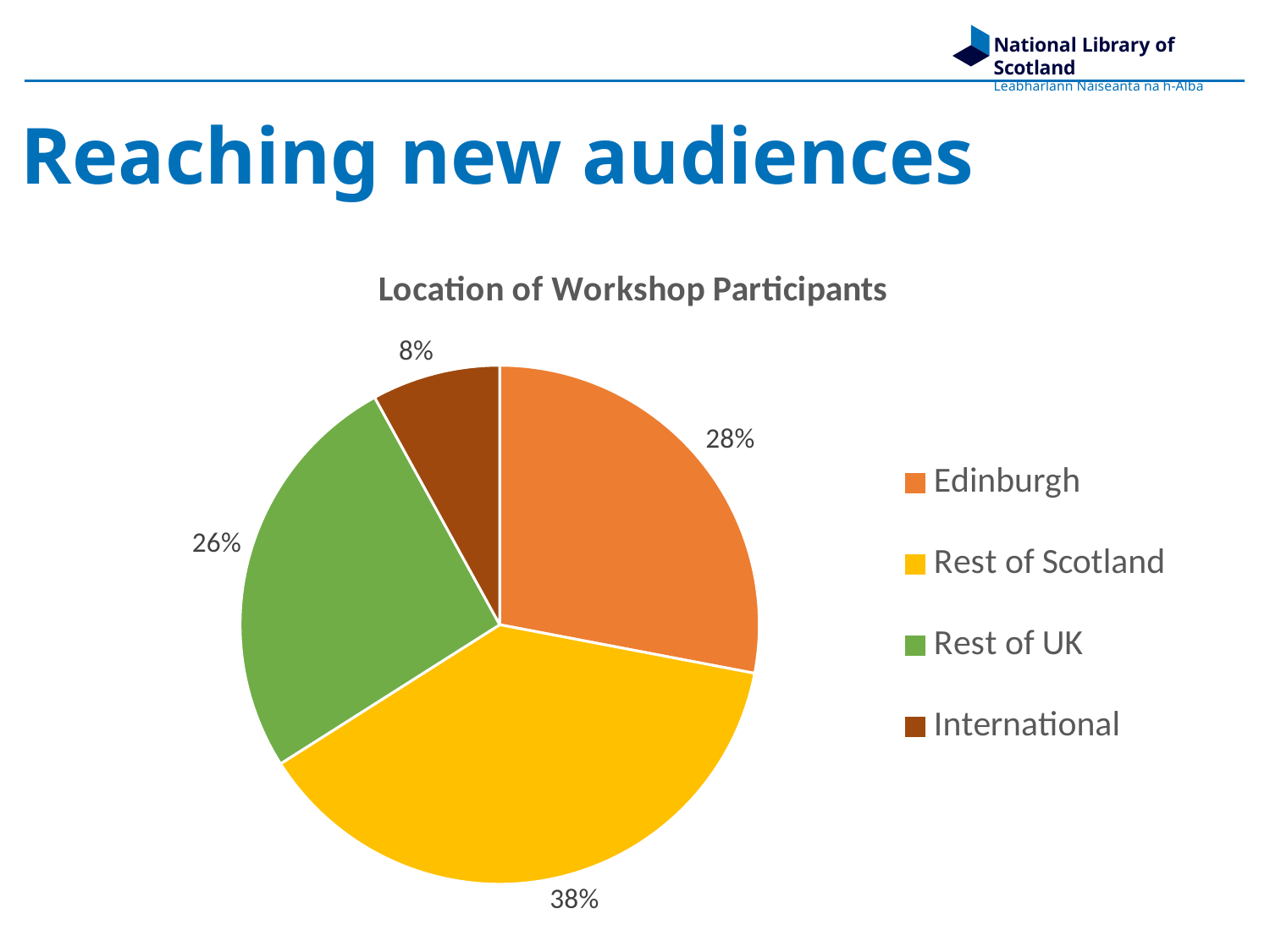
What type of chart is shown on the slide? Pie chart Which location accounts for the largest share of workshop participants? Rest of Scotland What colour represents the Rest of UK slice in the pie chart? Green What share of workshop participants were from the Rest of UK? 26% What share of workshop participants were International? 8% What share of workshop participants were from Edinburgh? 28% Which has a larger share of participants, Edinburgh or Rest of UK? Edinburgh What share of workshop participants were from the Rest of Scotland? 38% How many location categories are shown in the pie chart? 4 Which location accounts for the smallest share of workshop participants? International What is the difference in percentage points between the Rest of Scotland and Edinburgh shares? 10 What is the title of the chart? Location of Workshop Participants